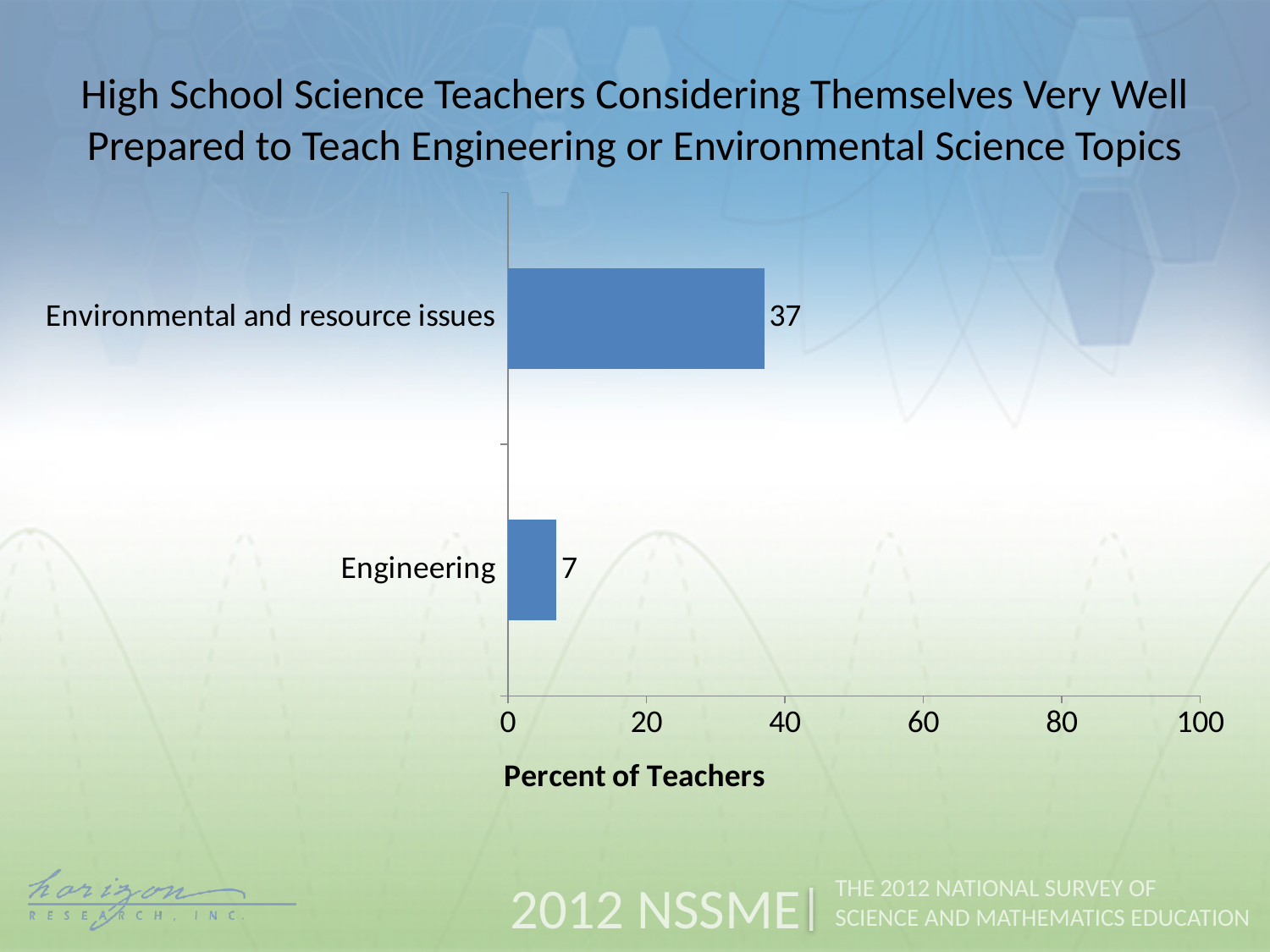
Is the value for environmental and resource issues greater or less than 20? greater What percent of teachers consider themselves very well prepared to teach engineering? 7 What is the label of the horizontal axis? Percent of Teachers Which topic has the lowest percent of teachers feeling very well prepared? Engineering What percent of teachers consider themselves very well prepared to teach environmental and resource issues? 37 What kind of chart is shown on the slide? bar chart Is the value for engineering greater or less than 20? less Which topic has the higher percent of teachers feeling very well prepared? Environmental and resource issues What is the maximum value shown on the horizontal axis? 100 How many topics are shown in the chart? 2 Is the value for engineering larger or smaller than the value for environmental and resource issues? smaller What is the difference in percent of teachers between environmental and resource issues and engineering? 30